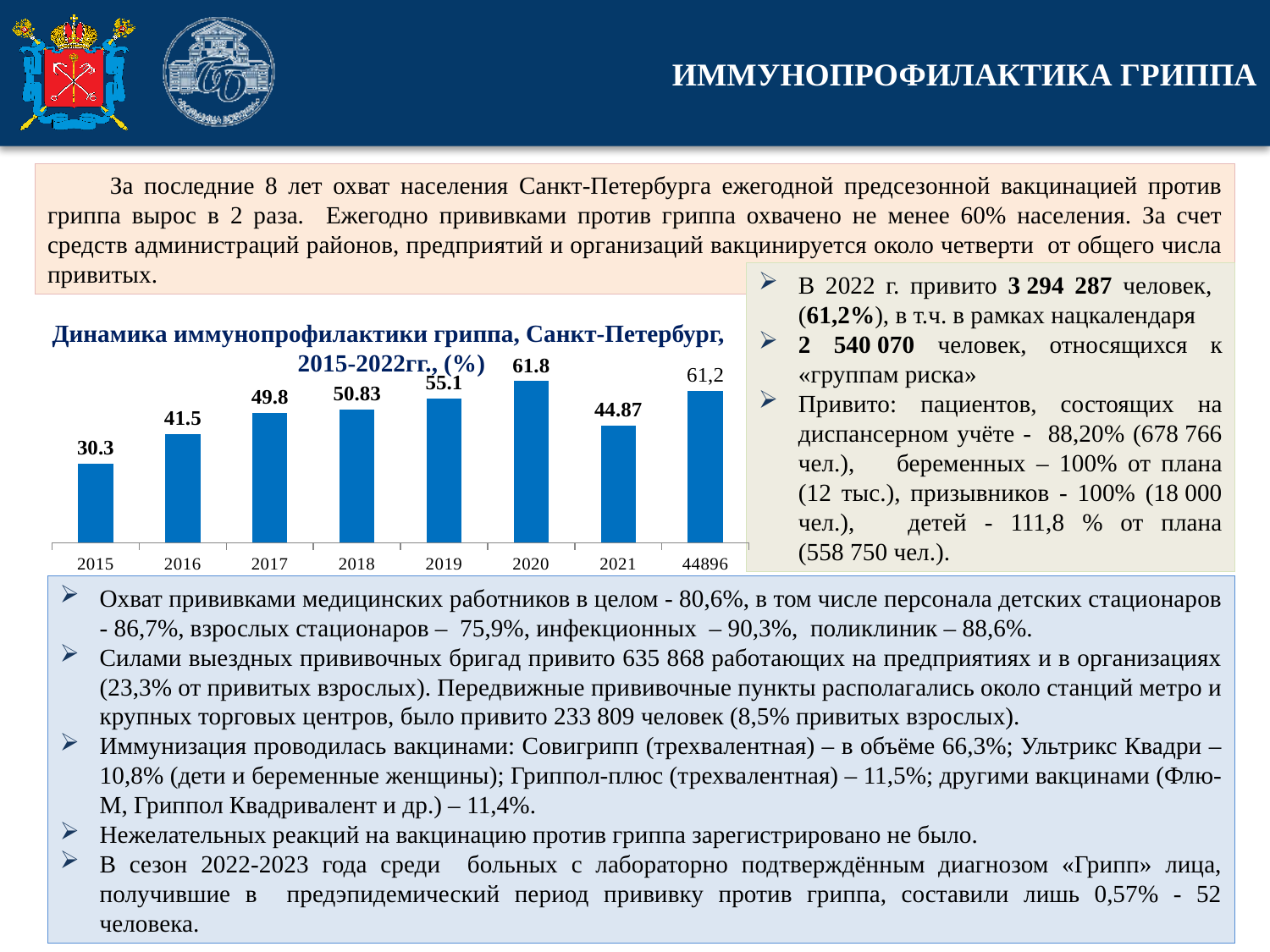
What is the value for 2021 in the chart? 44.87 Do the values rise or fall from 2015 to 2020? Rise Which is larger, the value for 2019 or the value for 2018? 2019 Which year has the highest value in the chart? 2020 What is the difference between the values for 2016 and 2015? 11.2 Which year has the lowest value in the chart? 2015 How many bars are shown in the chart? 8 What is the value for 2020 in the chart? 61.8 What is the value for 2015 in the chart 'Динамика иммунопрофилактики гриппа, Санкт-Петербург, 2015-2022гг., (%)'? 30.3 What is the difference between the values for 2020 and 2021? 16.93 What value is labelled on the last (rightmost) bar of the chart? 61,2 What kind of chart is shown on the slide? Bar chart